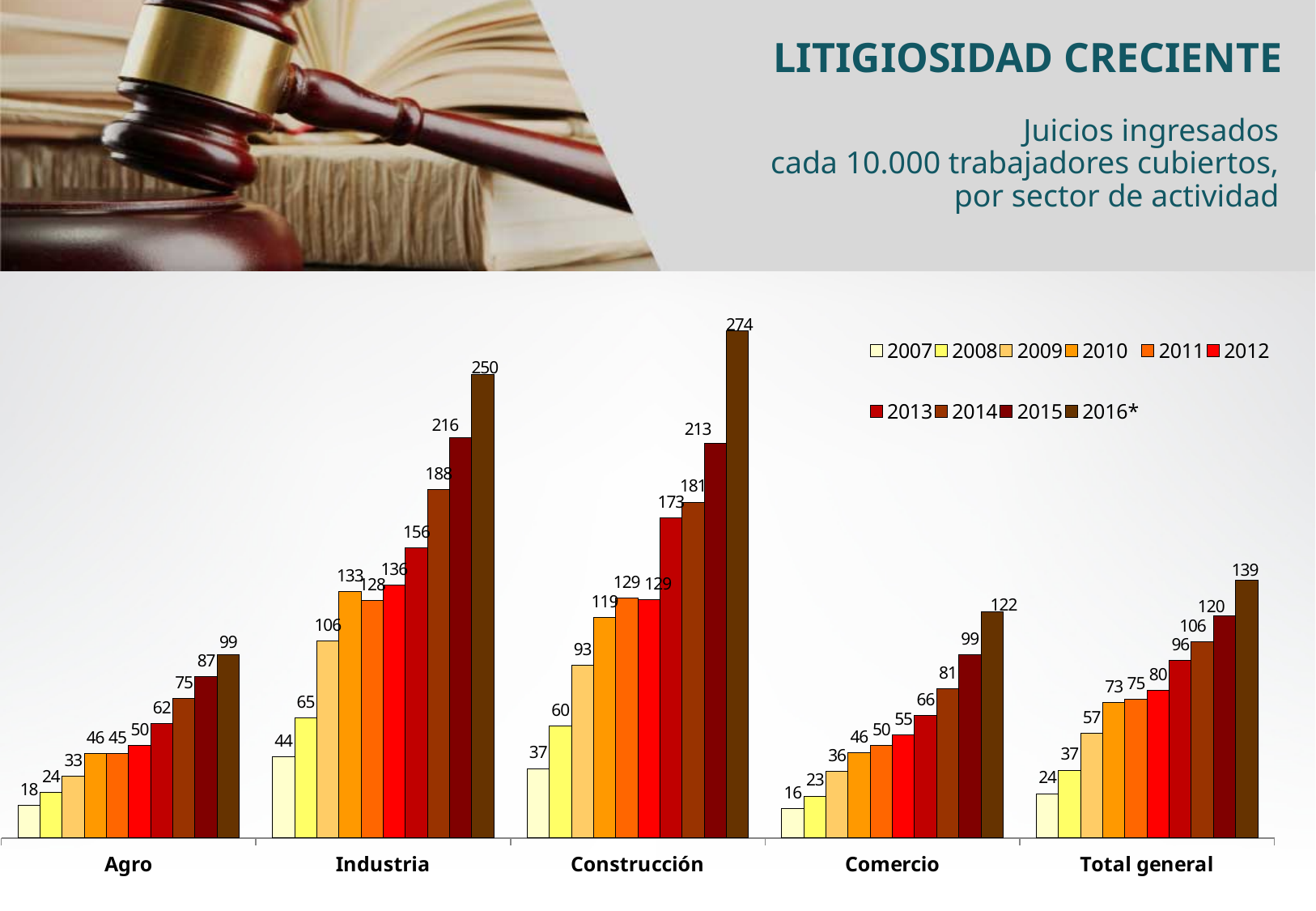
What is the value for Comercio in 2012? 55 What is the value for Total general in 2015? 120 Which is larger, the 2014 value for Industria or the 2014 value for Construcción? Industria What kind of chart is shown on the slide? Bar chart What is the value for Construcción in 2016*? 274 Which sector has the lowest value in 2007? Comercio What is the difference between the 2016* and 2007 values for Industria? 206 How many series does the legend list? 10 What is the value for Agro in 2007? 18 How many sector categories are shown on the x axis? 5 Do the values for Comercio rise or fall from 2007 to 2016*? Rise Which sector has the highest value in 2016*? Construcción